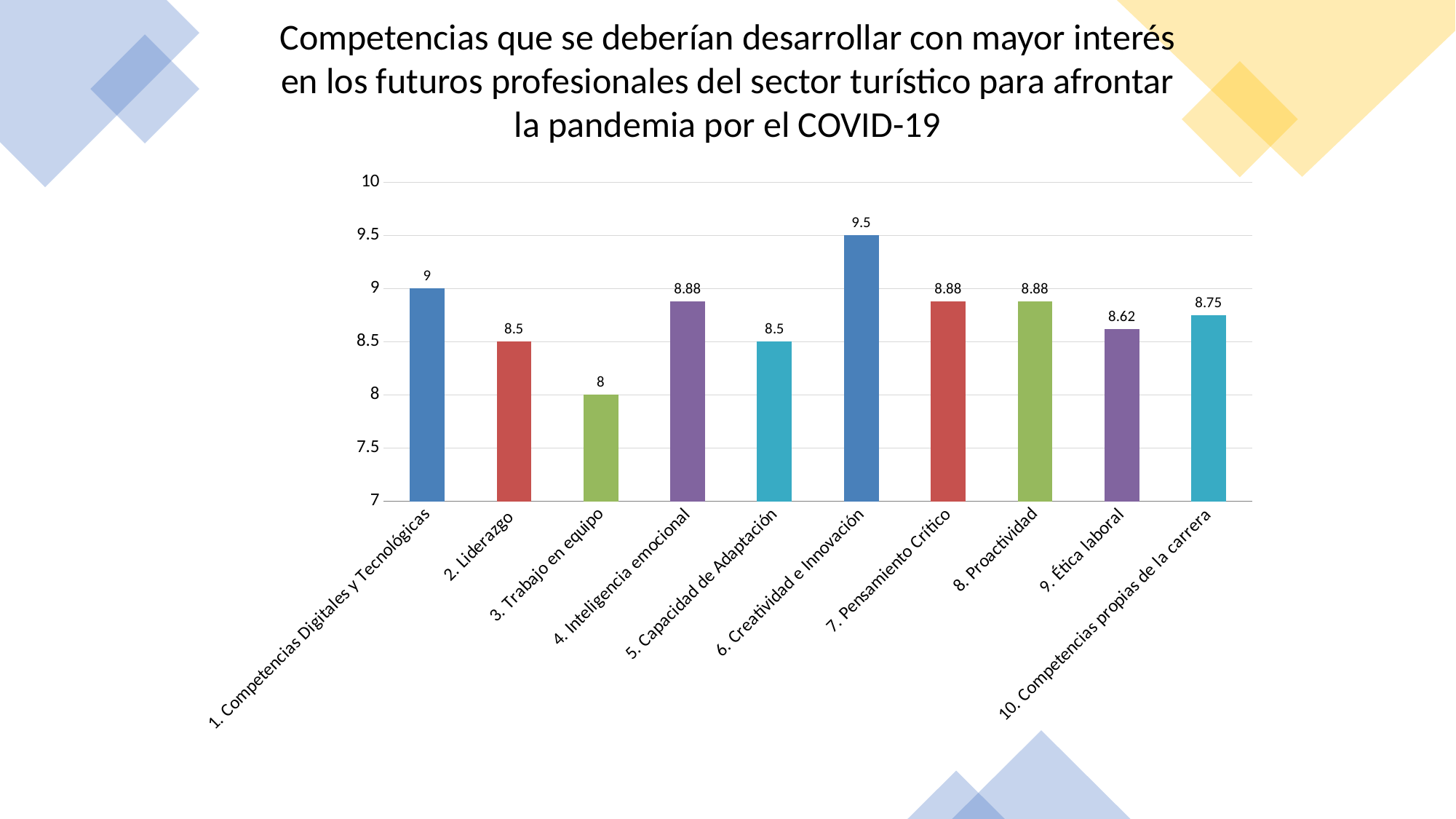
What kind of chart is shown on the slide? bar chart Which is larger, the value for 4. Inteligencia emocional or the value for 10. Competencias propias de la carrera? 4. Inteligencia emocional What is the value for 9. Ética laboral? 8.62 What is the difference between the values for 1. Competencias Digitales y Tecnológicas and 2. Liderazgo? 0.5 What is the value for 10. Competencias propias de la carrera? 8.75 Is the value for 9. Ética laboral greater or less than 8.5? greater How many categories are shown on the x axis? 10 Which category has the lowest value? 3. Trabajo en equipo What is the difference between the values for 6. Creatividad e Innovación and 3. Trabajo en equipo? 1.5 Which category has the highest value? 6. Creatividad e Innovación What is the value for 6. Creatividad e Innovación? 9.5 How many categories have a value of 8.88? 3